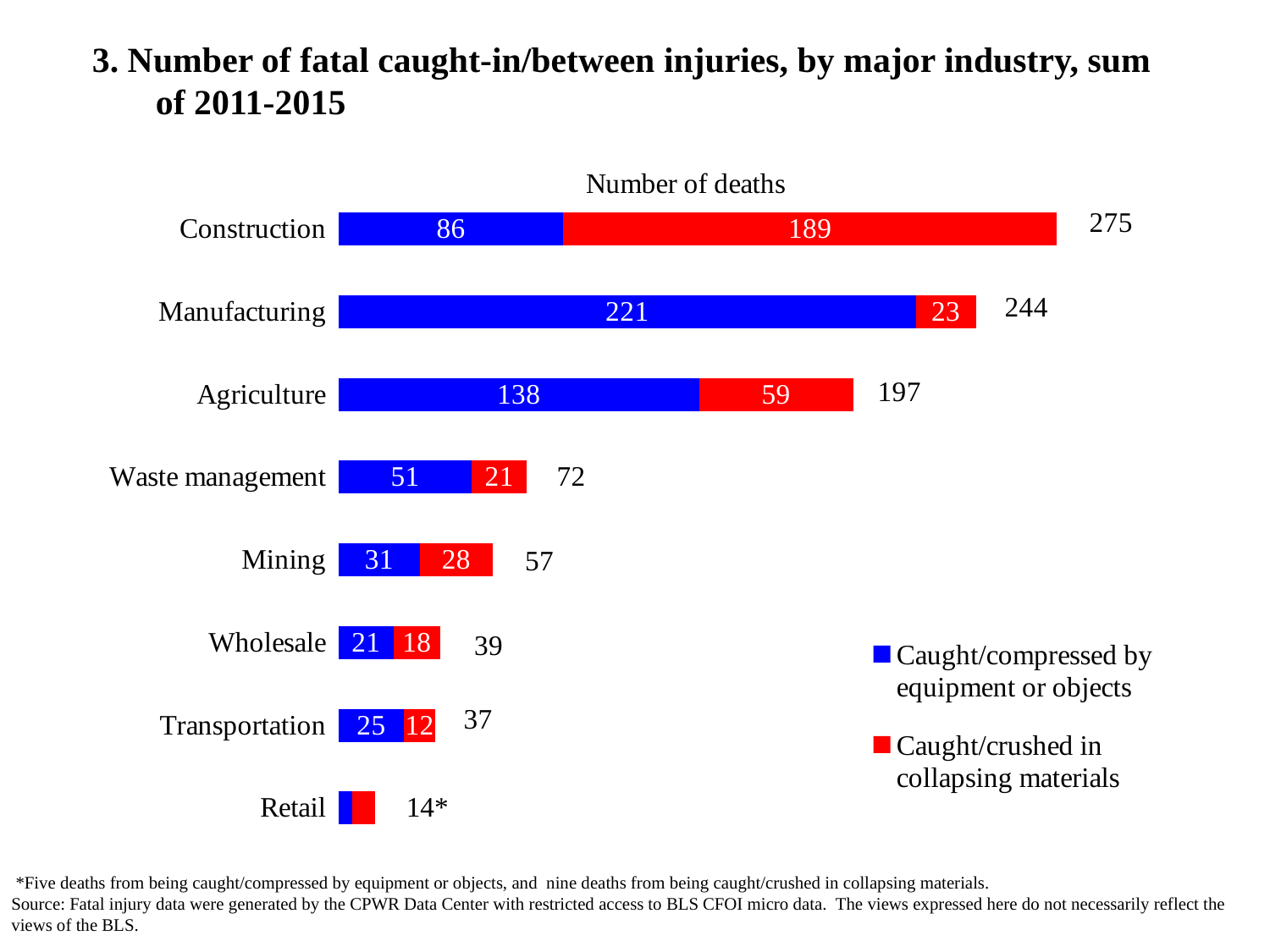
What kind of chart is shown on the slide? Stacked bar chart Which industry has the lowest total number of deaths? Retail What is the number of deaths from being caught/compressed by equipment or objects in Construction? 86 Which industry has the highest total number of deaths? Construction How many industries are shown in the chart? 8 What is the number of deaths from being caught/crushed in collapsing materials in Manufacturing? 23 What is the difference between the caught/crushed in collapsing materials deaths in Construction and in Agriculture? 130 How many series does the legend list? 2 Which colour represents deaths from being caught/crushed in collapsing materials? Red What is the total number of deaths shown for Agriculture? 197 What is the total number of deaths shown for Waste management? 72 Which is larger: the caught/compressed by equipment or objects deaths in Mining or in Wholesale? Mining